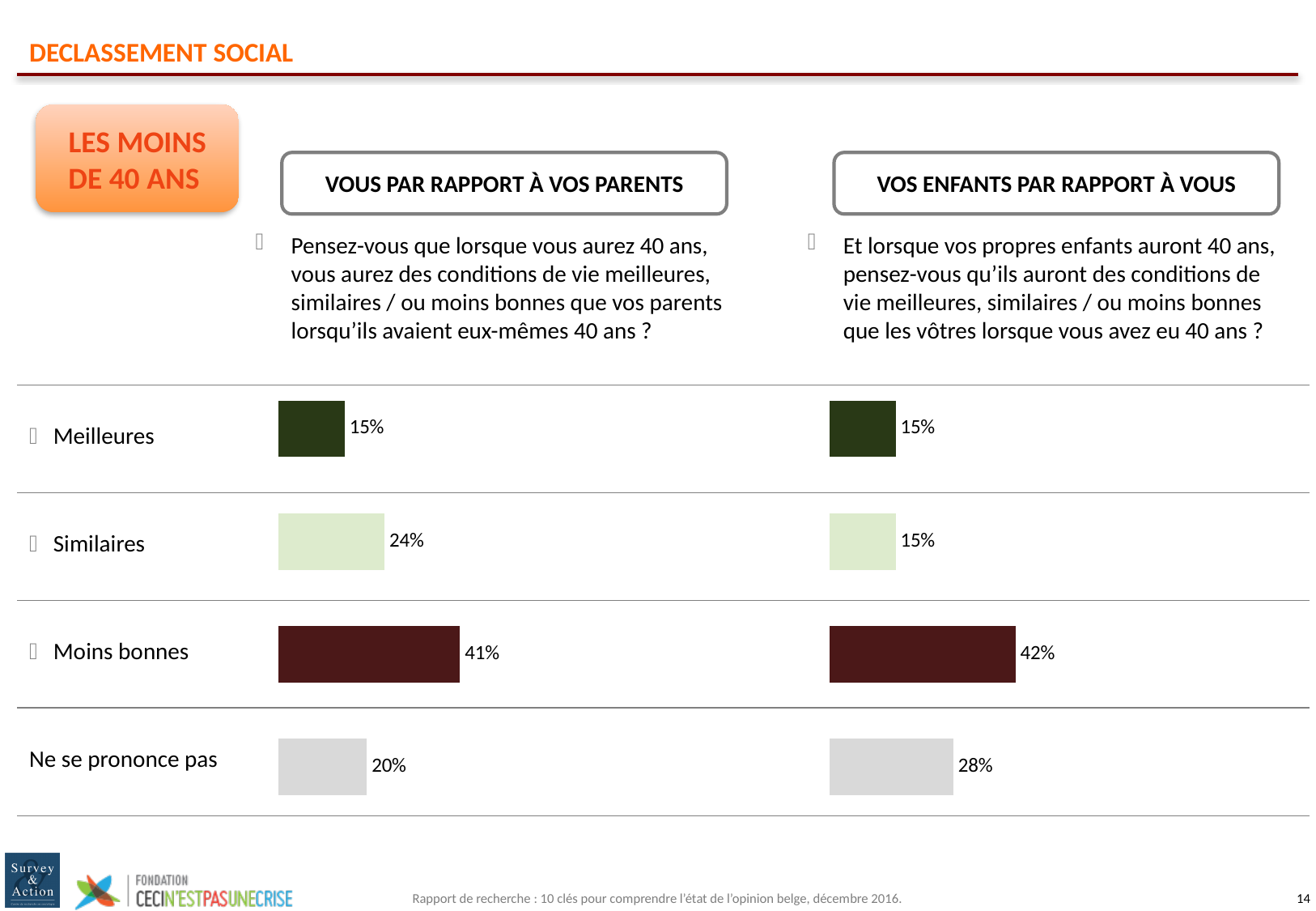
In the chart 'VOUS PAR RAPPORT À VOS PARENTS', what is the difference between 'Moins bonnes' and 'Similaires'? 17 percentage points Which is larger: 'Ne se prononce pas' in the chart 'VOUS PAR RAPPORT À VOS PARENTS' or 'Ne se prononce pas' in the chart 'VOS ENFANTS PAR RAPPORT À VOUS'? VOS ENFANTS PAR RAPPORT À VOUS In the chart 'VOUS PAR RAPPORT À VOS PARENTS', which category has the lowest value? Meilleures In the chart 'VOS ENFANTS PAR RAPPORT À VOUS', what is the difference between 'Moins bonnes' and 'Ne se prononce pas'? 14 percentage points In the chart 'VOUS PAR RAPPORT À VOS PARENTS', what is the value for 'Similaires'? 24% How many categories does the chart 'VOUS PAR RAPPORT À VOS PARENTS' show? 4 What kind of chart is used for 'VOS ENFANTS PAR RAPPORT À VOUS'? Bar chart In the chart 'VOUS PAR RAPPORT À VOS PARENTS', which category has the highest value? Moins bonnes In the chart 'VOUS PAR RAPPORT À VOS PARENTS', what is the value for 'Moins bonnes'? 41% In the chart 'VOS ENFANTS PAR RAPPORT À VOUS', what is the value for 'Moins bonnes'? 42% In the chart 'VOS ENFANTS PAR RAPPORT À VOUS', what is the value for 'Ne se prononce pas'? 28% In the chart 'VOS ENFANTS PAR RAPPORT À VOUS', which category has the highest value? Moins bonnes